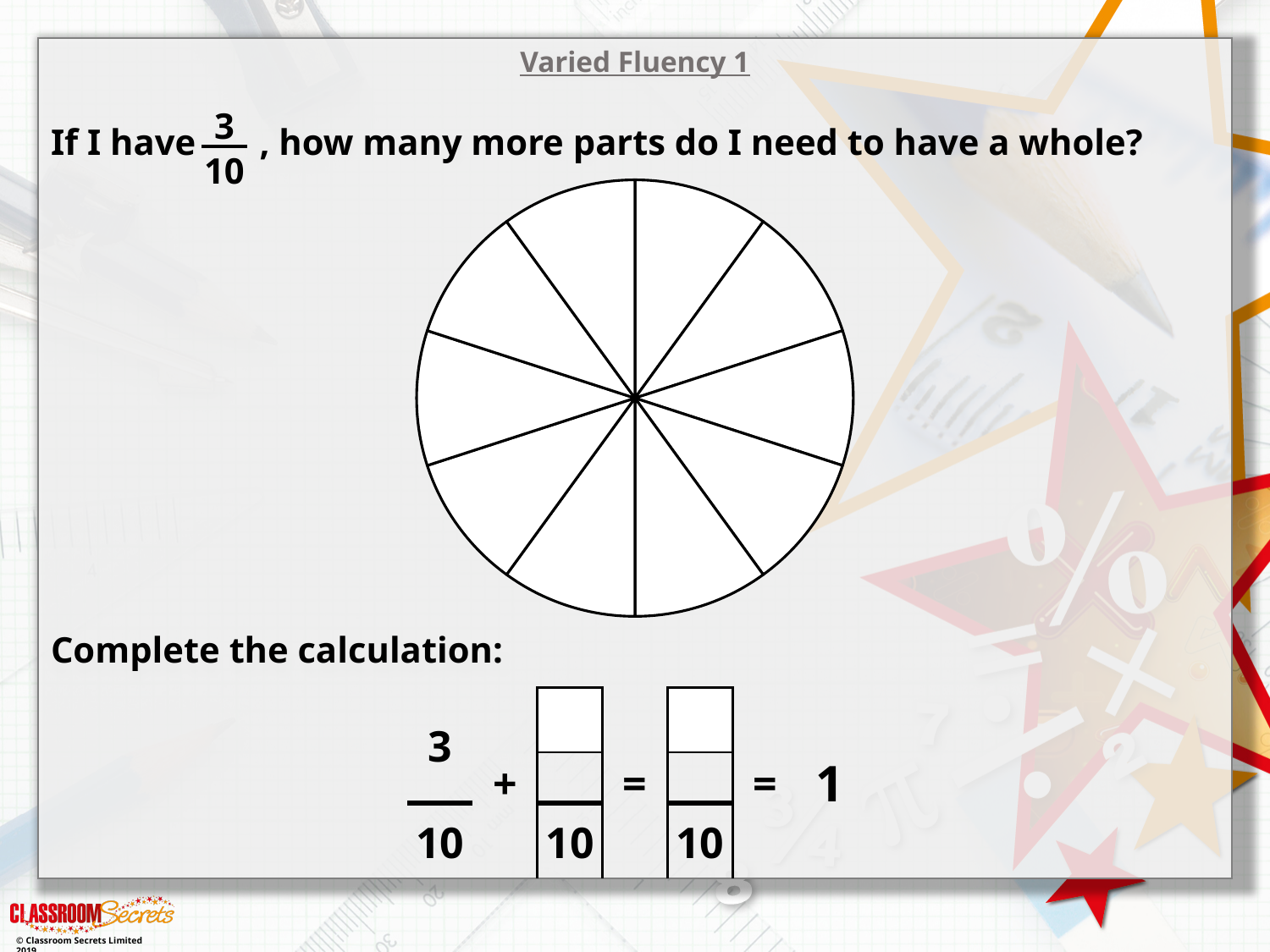
How many of the circle's parts are shaded? 0 What kind of chart or diagram is shown in the middle of the slide? A circle (pie) divided into equal parts How many equal parts is the circle on the slide divided into? 10 What denominator appears in every fraction in the calculation below the circle? 10 What is the title shown at the top of the slide? Varied Fluency 1 What fraction does each single part of the circle represent? 1/10